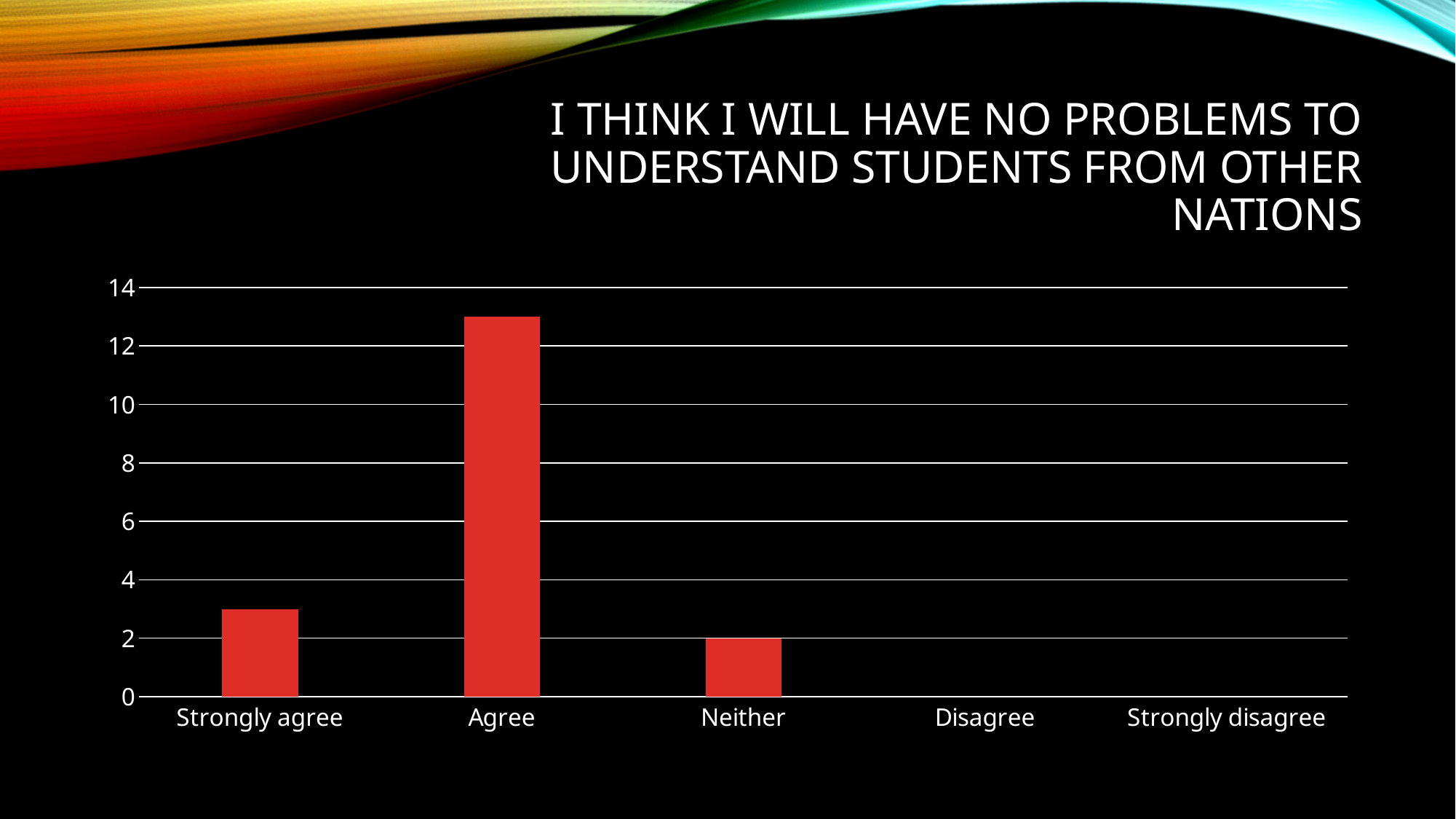
What is the title of the chart? I think I will have no problems to understand students from other nations Which is larger, the value for Agree or the value for Strongly agree? Agree Which is larger, the value for Strongly agree or the value for Neither? Strongly agree What is the value for Neither? 2 Is the value for Agree greater or less than 12? greater Which category has the highest value? Agree Is the value for Strongly agree greater or less than 4? less What kind of chart is shown on the slide? Bar chart How many categories are shown on the x axis? 5 Is the value for Strongly agree greater or less than 2? greater